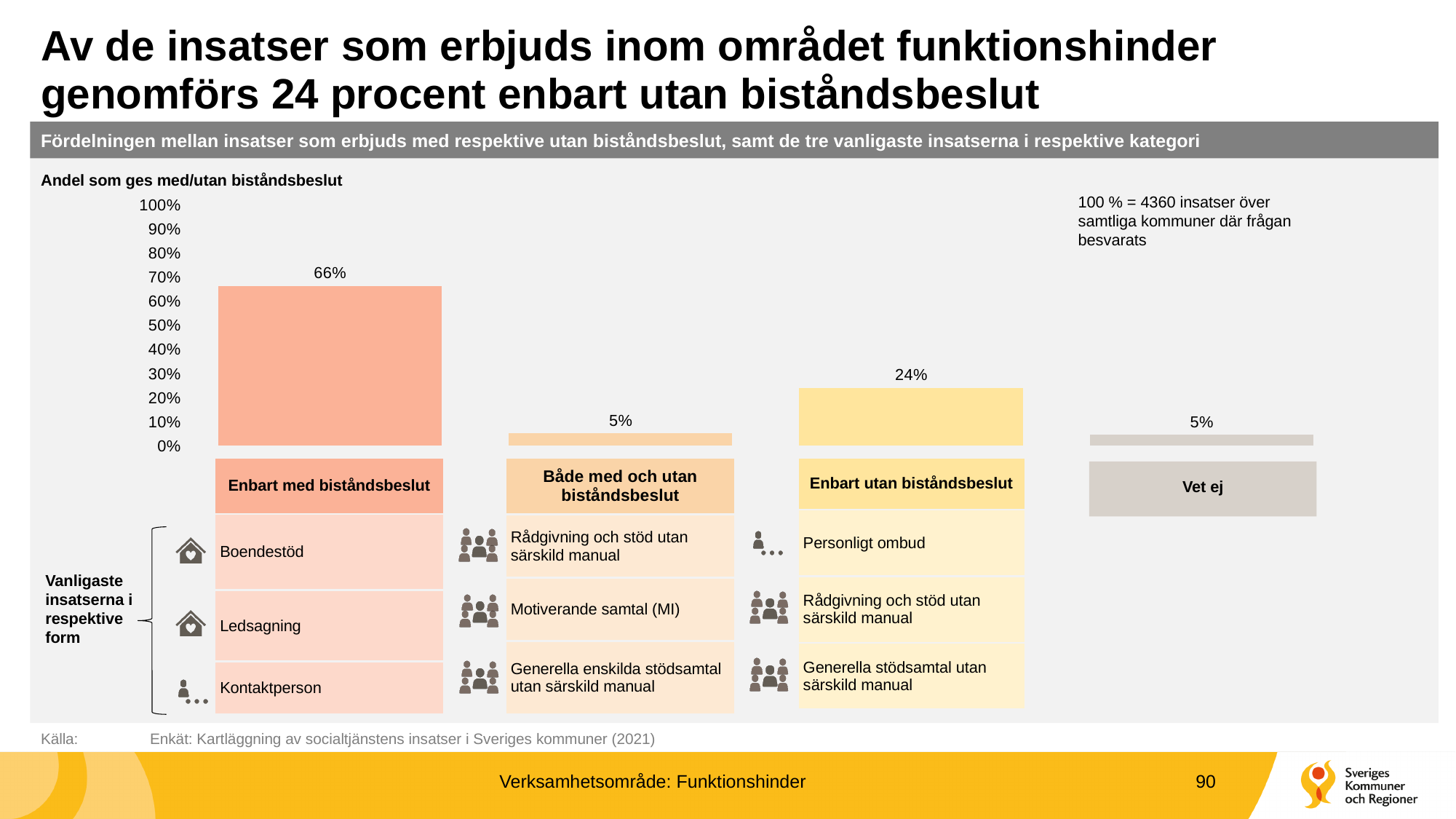
What is the value for "Både med och utan biståndsbeslut"? 5% What is the total of the values for "Både med och utan biståndsbeslut" and "Vet ej"? 10% Which category has the highest value? Enbart med biståndsbeslut Which is larger, the value for "Enbart utan biståndsbeslut" or the value for "Vet ej"? Enbart utan biståndsbeslut Is the value for "Enbart med biståndsbeslut" greater or less than 50%? greater According to the note on the chart, how many insatser does 100% correspond to? 4360 What kind of chart is shown on the slide? bar chart How many categories are shown in the bar chart? 4 What is the value for "Enbart utan biståndsbeslut"? 24% What is the value for "Enbart med biståndsbeslut"? 66% What is the difference between the values for "Enbart med biståndsbeslut" and "Enbart utan biståndsbeslut"? 42% What is the value for "Vet ej"? 5%